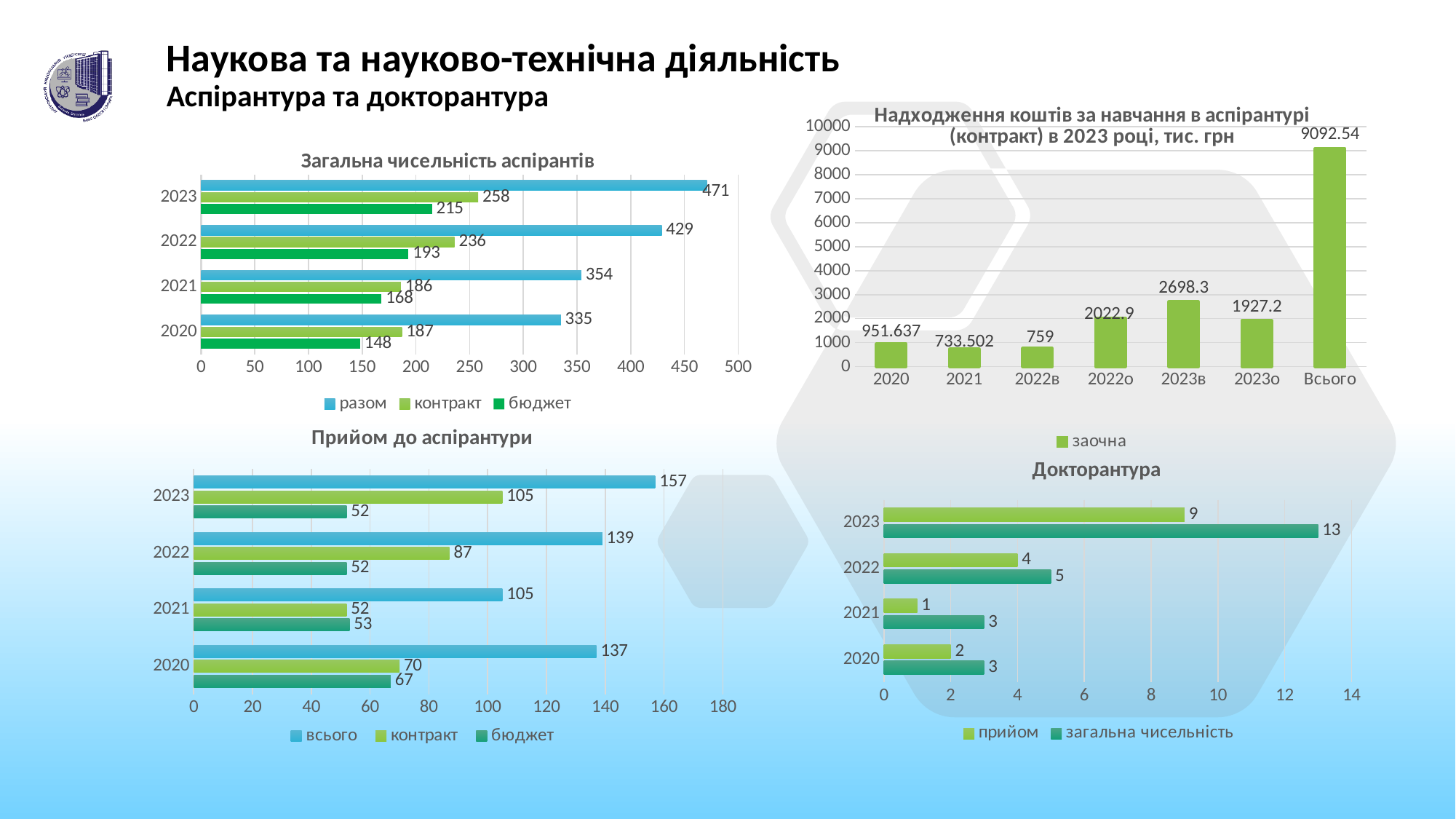
In the chart 'Надходження коштів за навчання в аспірантурі (контракт) в 2023 році, тис. грн', which category has the lowest value? 2021 What type of chart is 'Докторантура'? bar chart In the chart 'Загальна чисельність аспірантів', what is the value of 'бюджет' for 2020? 148 In the chart 'Прийом до аспірантури', what is the value of 'всього' for 2022? 139 In the chart 'Прийом до аспірантури', which year has the highest 'всього' value? 2023 In the chart 'Надходження коштів за навчання в аспірантурі (контракт) в 2023 році, тис. грн', how many categories are shown on the x axis? 7 In the chart 'Загальна чисельність аспірантів', what is the difference between 'контракт' and 'бюджет' for 2022? 43 In the chart 'Загальна чисельність аспірантів', what is the value of 'разом' for 2023? 471 In the chart 'Прийом до аспірантури', which is larger for 2021: 'контракт' or 'бюджет'? бюджет In the chart 'Докторантура', how many series does the legend list? 2 In the chart 'Докторантура', what is the value of 'загальна чисельність' for 2023? 13 In the chart 'Надходження коштів за навчання в аспірантурі (контракт) в 2023 році, тис. грн', what is the value for 2023в? 2698.3